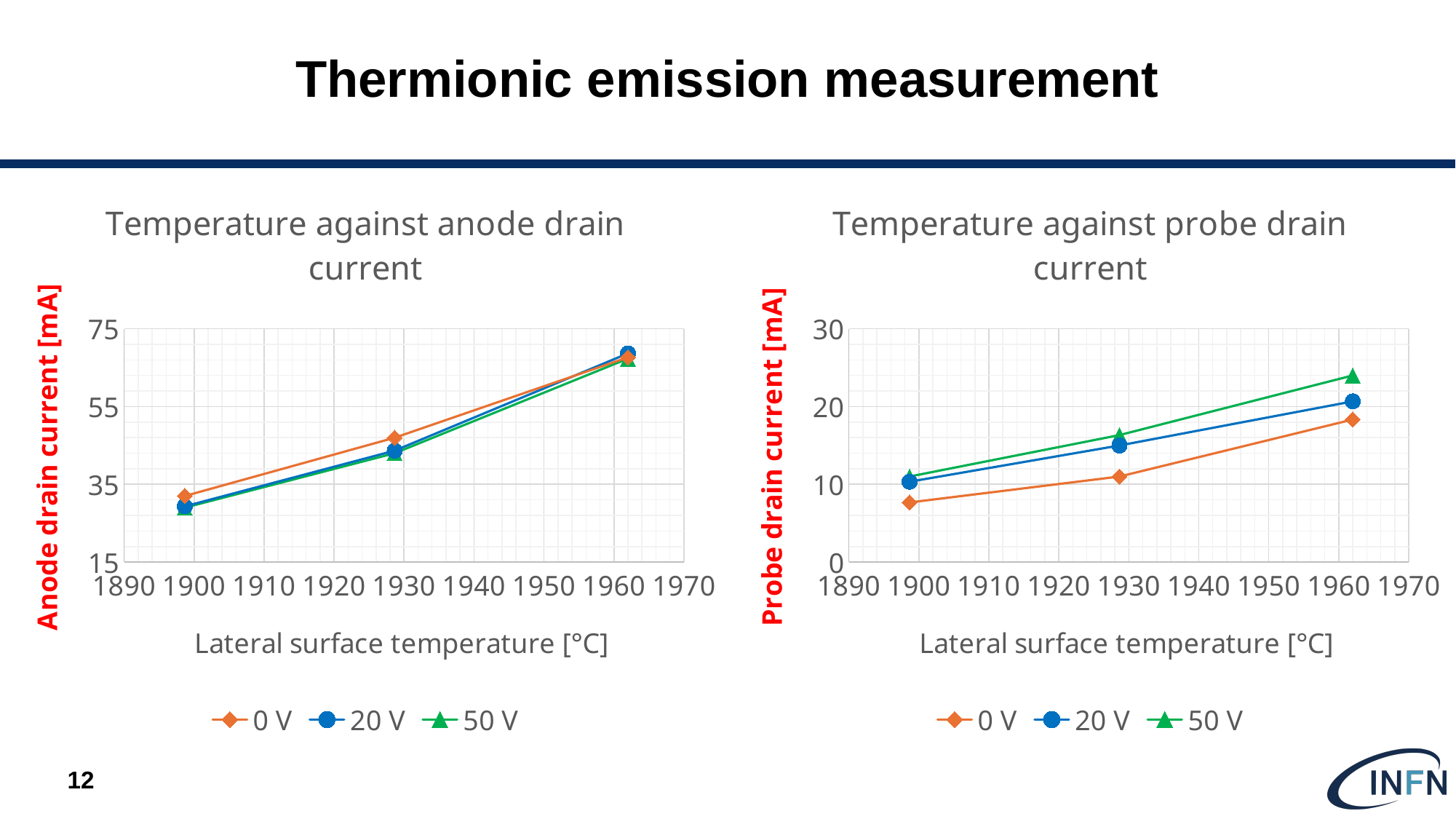
How many series does the legend of the "Temperature against probe drain current" chart list? 3 What kind of chart is the "Temperature against anode drain current" chart? line chart In the "Temperature against anode drain current" chart, is the value of the 0 V series at its highest temperature point greater or less than 55? greater In the "Temperature against anode drain current" chart, how many data points does the 0 V series have? 3 In the "Temperature against probe drain current" chart, is the value of the 50 V series at its highest temperature point greater or less than 20? greater In the "Temperature against probe drain current" chart, does the 50 V series rise or fall as temperature increases? rise In the "Temperature against anode drain current" chart, is the value of the 50 V series at its lowest temperature point greater or less than 35? less What is the y-axis label of the "Temperature against probe drain current" chart? Probe drain current [mA] In the "Temperature against probe drain current" chart, at the highest temperature point, which series has the larger value: 0 V or 50 V? 50 V What is the x-axis label of the "Temperature against anode drain current" chart? Lateral surface temperature [°C] In the "Temperature against probe drain current" chart, which series has the lowest value at the highest temperature point? 0 V